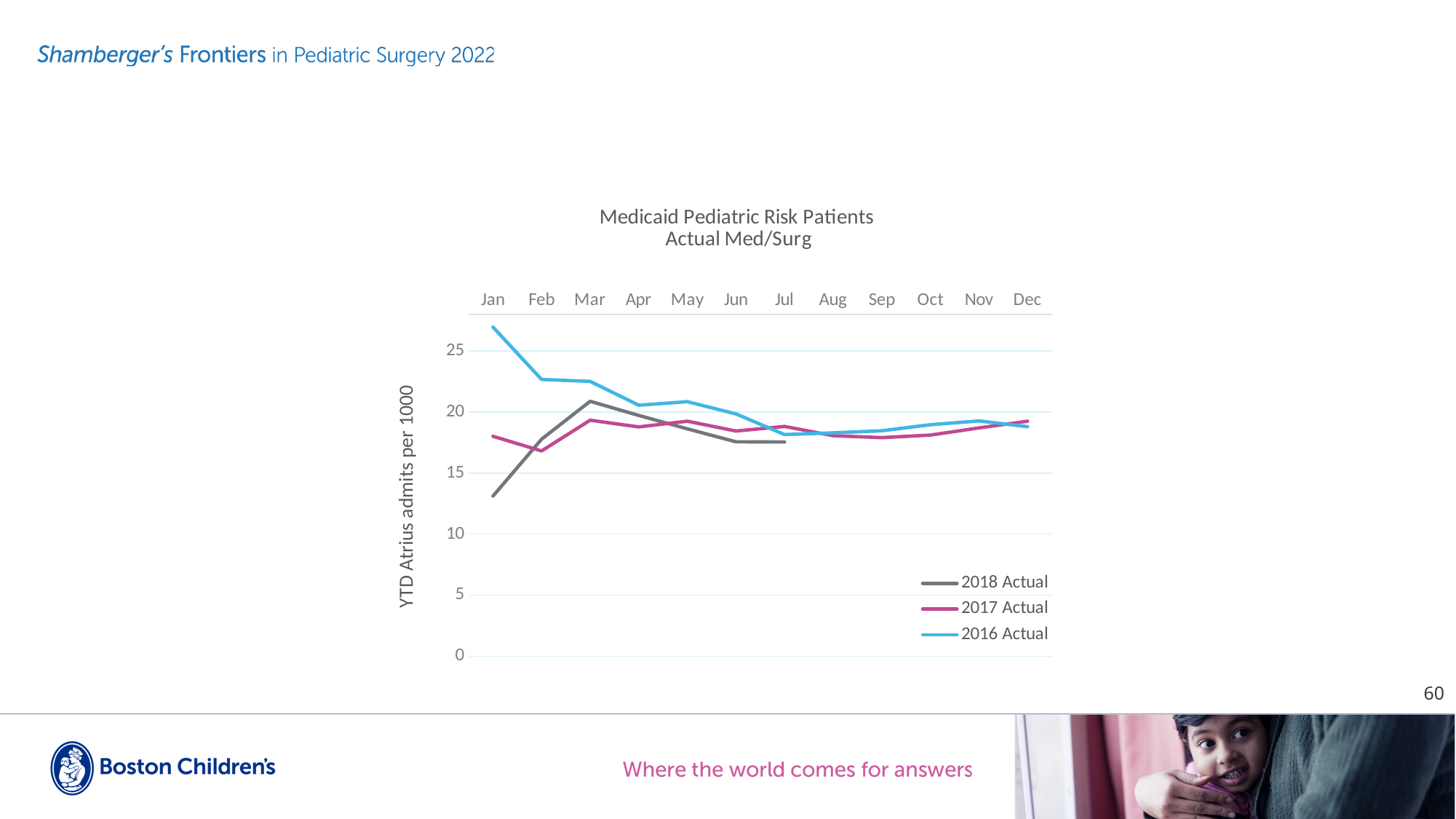
Is the value for 2018 Actual in Jan greater or less than 15? less What is the label on the y axis of the chart? YTD Atrius admits per 1000 Is the value for 2018 Actual in Mar greater or less than 20? greater In which month does the 2016 Actual series reach its highest value? Jan How many months are shown along the x axis? 12 How many series does the legend list? 3 In Jan, which series has the larger value, 2016 Actual or 2018 Actual? 2016 Actual Is the value for 2016 Actual in Jan greater or less than 25? greater Does the 2016 Actual series rise or fall from Jan to Jul? fall What kind of chart is shown on the slide? line chart In which month does the 2018 Actual series have its lowest value? Jan